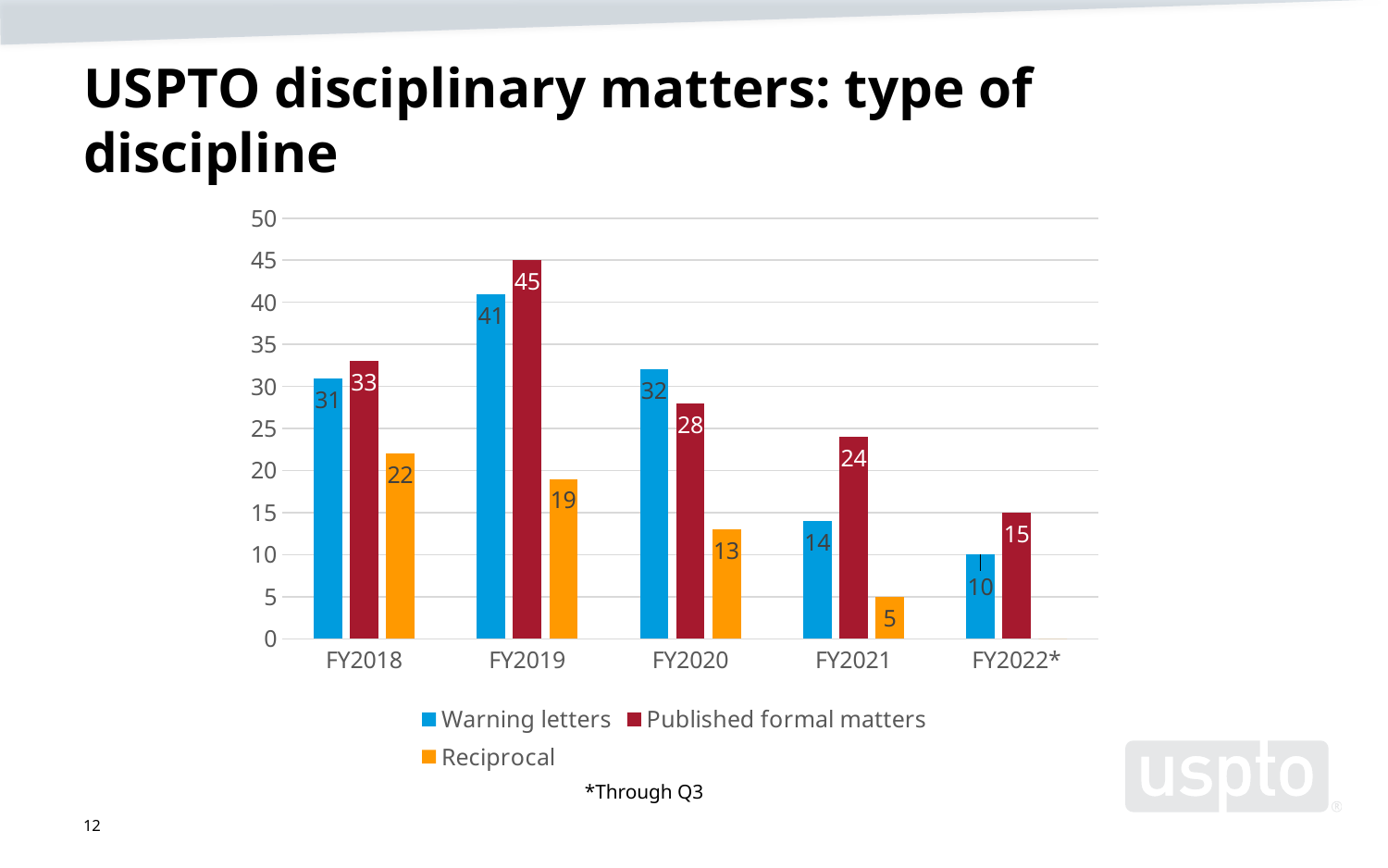
Do the Reciprocal values rise or fall from FY2018 to FY2021? fall What is the value for Reciprocal in FY2018? 22 How many series does the legend list? 3 What type of chart is shown on the slide? bar chart How many fiscal years are shown on the x axis? 5 In which fiscal year is the Warning letters value highest? FY2019 What is the value for Published formal matters in FY2019? 45 What does the asterisk on FY2022* indicate, according to the note below the chart? Through Q3 In which fiscal year is the Reciprocal value lowest among the years where a Reciprocal bar is shown? FY2021 Which is larger in FY2020, Warning letters or Published formal matters? Warning letters What is the value for Warning letters in FY2021? 14 What is the difference between Published formal matters and Warning letters in FY2021? 10